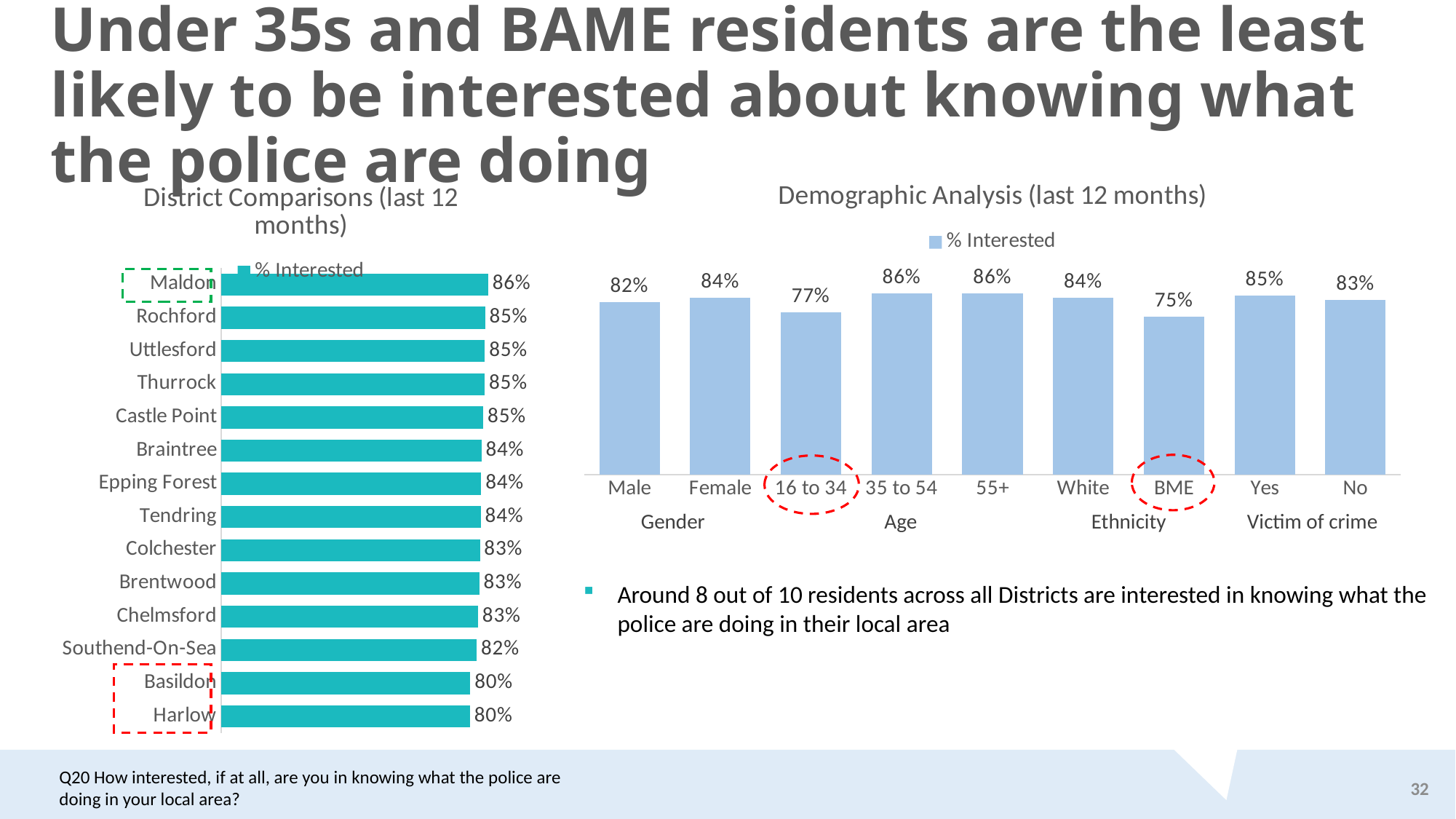
In the Demographic Analysis chart, what is the difference between White and BME? 9% In the District Comparisons chart, what is the % Interested value for Maldon? 86% In the District Comparisons chart, how many districts are shown? 14 In the Demographic Analysis chart, what is the % Interested value for BME? 75% In the District Comparisons chart, what is the difference between Maldon and Harlow? 6% In the Demographic Analysis chart, which category has the lowest % Interested? BME What kind of chart is the District Comparisons chart? Bar chart In the Demographic Analysis chart, what is the % Interested value for 16 to 34? 77% In the District Comparisons chart, what is the % Interested value for Southend-On-Sea? 82% How many series does the legend of the Demographic Analysis chart list? 1 In the Demographic Analysis chart, which is larger, the value for Male or the value for Female? Female In the District Comparisons chart, which district has the highest % Interested? Maldon